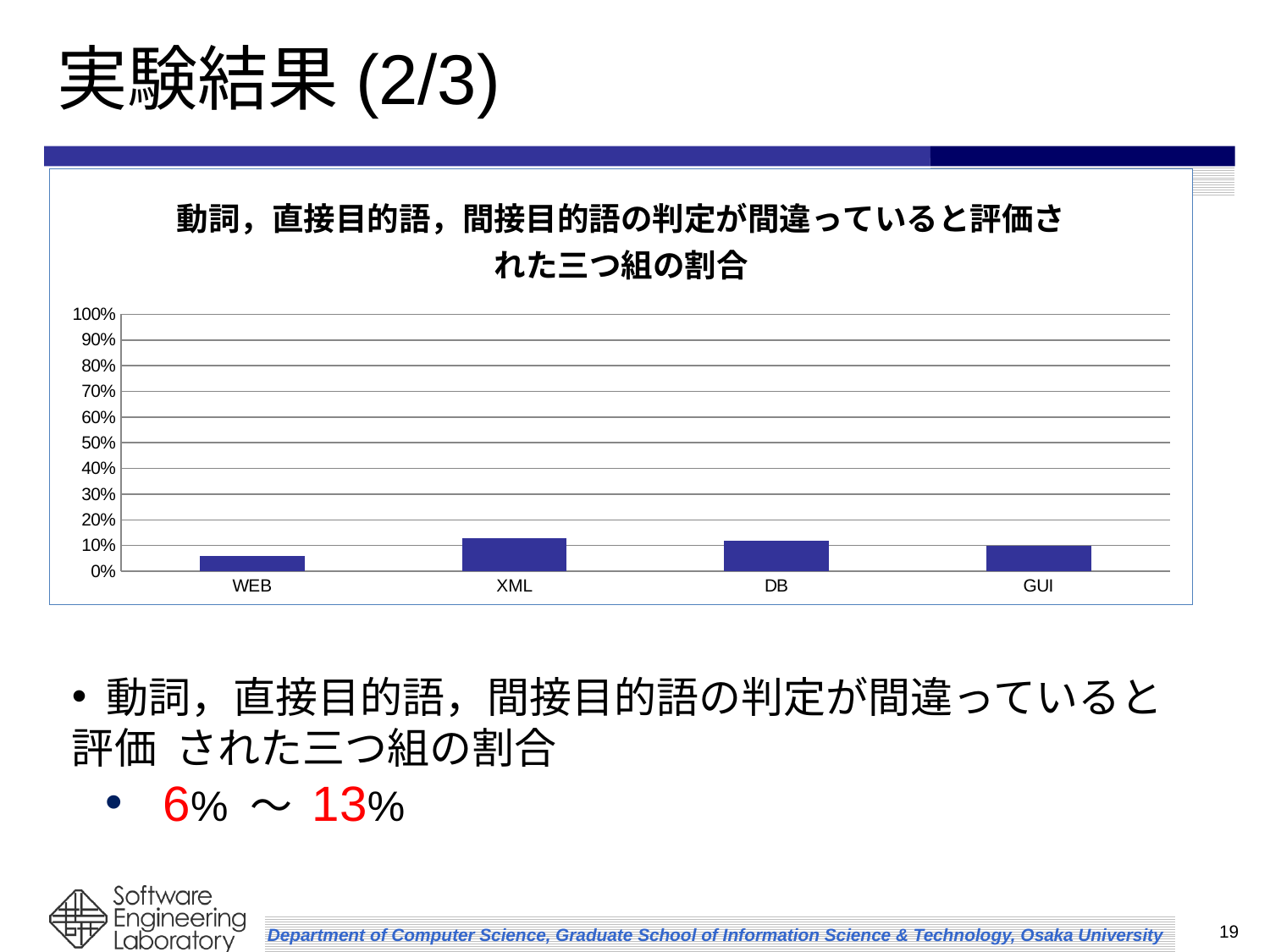
Which has the larger value, GUI or WEB? GUI What is the highest value shown on the y axis of the chart? 100% Which has the larger value, WEB or XML? XML What kind of chart is shown on the slide? bar chart Is the value for XML greater or less than 10%? greater Is the value for DB greater or less than 20%? less How many categories are shown on the x axis of the chart? 4 Is the value for WEB greater or less than 10%? less Which category has the lowest value in the chart? WEB Which has the larger value, DB or WEB? DB What is the label of the last category on the x axis of the chart? GUI